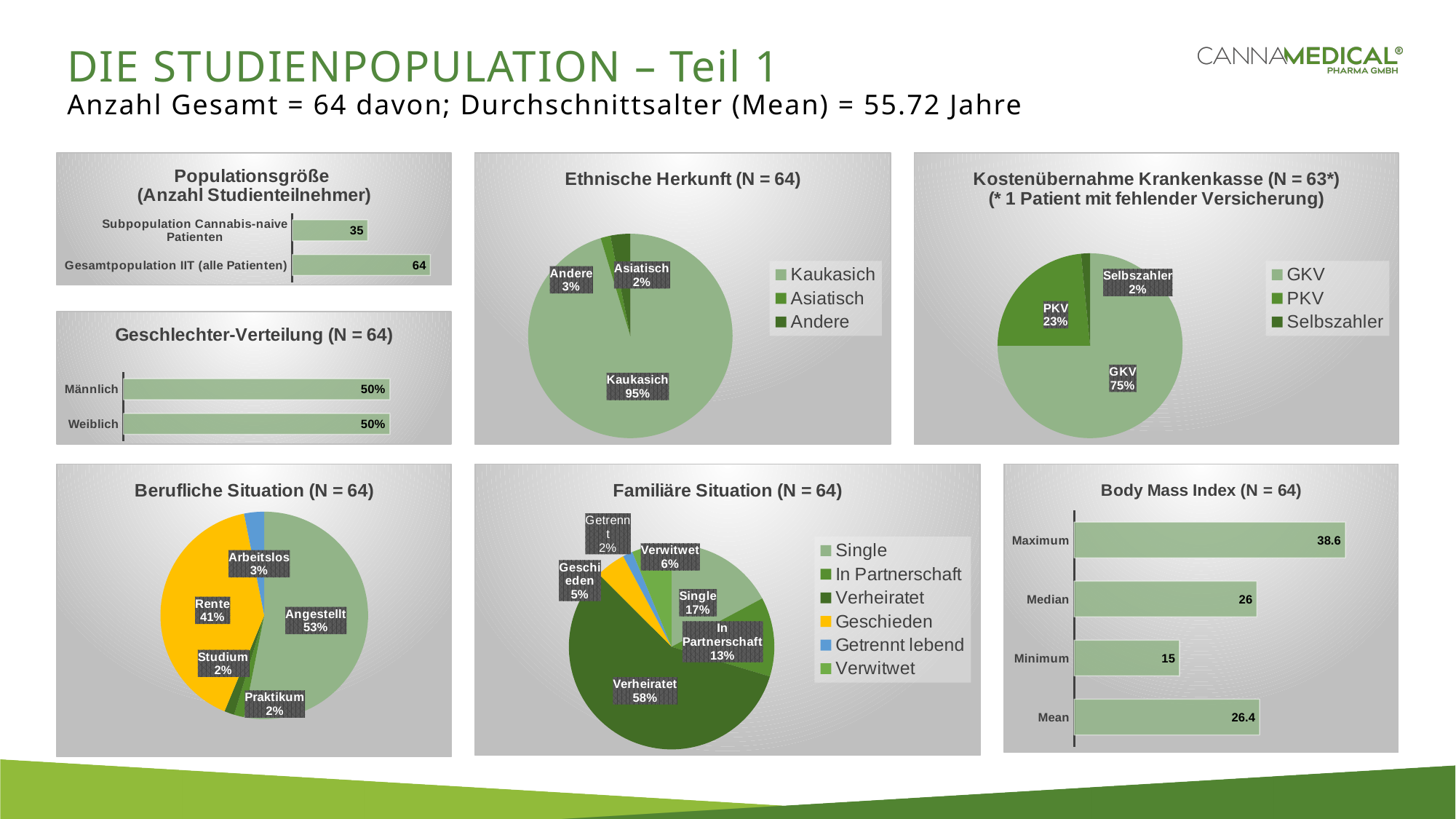
In the 'Familiäre Situation' pie chart, which is larger, Single or In Partnerschaft? Single In the 'Berufliche Situation' pie chart, what share does Rente have? 41% In the 'Ethnische Herkunft' pie chart, what share does Kaukasich have? 95% In the 'Kostenübernahme Krankenkasse' chart, how many entries does the legend list? 3 In the 'Populationsgröße' chart, what is the value for Subpopulation Cannabis-naive Patienten? 35 In the 'Ethnische Herkunft' pie chart, which category has the smallest share? Asiatisch In the 'Familiäre Situation' chart, how many categories does the legend list? 6 In the 'Populationsgröße' chart, what is the difference between Gesamtpopulation IIT (alle Patienten) and Subpopulation Cannabis-naive Patienten? 29 In the 'Berufliche Situation' pie chart, which category has the largest share? Angestellt In the 'Kostenübernahme Krankenkasse' pie chart, what share does PKV have? 23% In the 'Body Mass Index' chart, what is the value for Mean? 26.4 In the 'Geschlechter-Verteilung' chart, what is the value for Weiblich? 50%